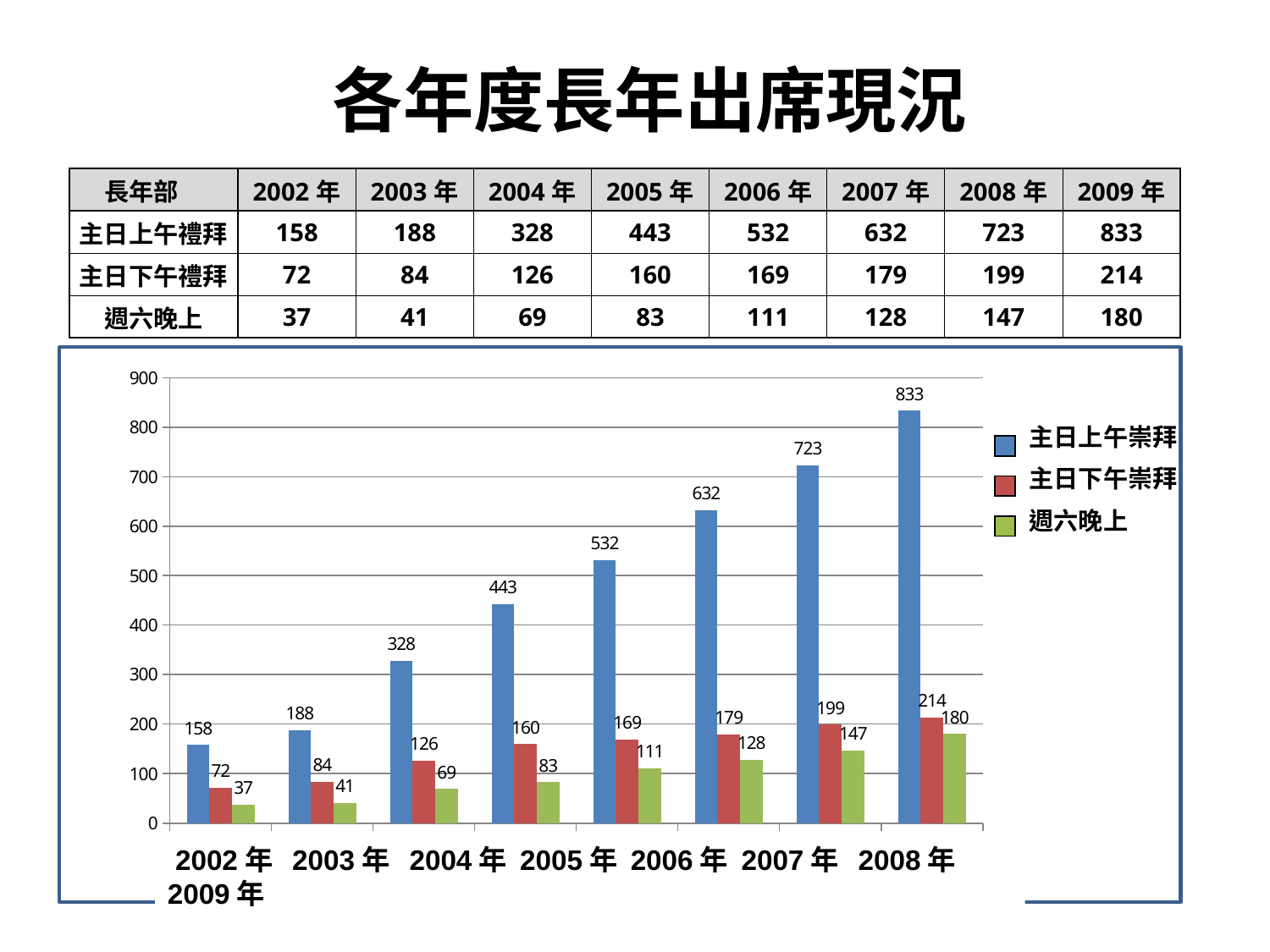
Do the 主日上午崇拜 values rise or fall from 2002年 to 2009年? rise What is the value for 主日上午崇拜 in 2005年? 443 What kind of chart is shown on the slide? bar chart What is the value for 週六晚上 in 2006年? 111 What is the value for 主日下午崇拜 in 2008年? 199 How many years are shown on the x axis of the chart? 8 Which year has the highest value for 主日上午崇拜? 2009年 How many series does the chart legend list? 3 Which year has the lowest value for 週六晚上? 2002年 Which is larger in 2004年: 主日下午崇拜 or 週六晚上? 主日下午崇拜 What colour are the bars for 週六晚上 in the chart? green What is the difference between the 主日上午崇拜 values for 2009年 and 2008年? 110